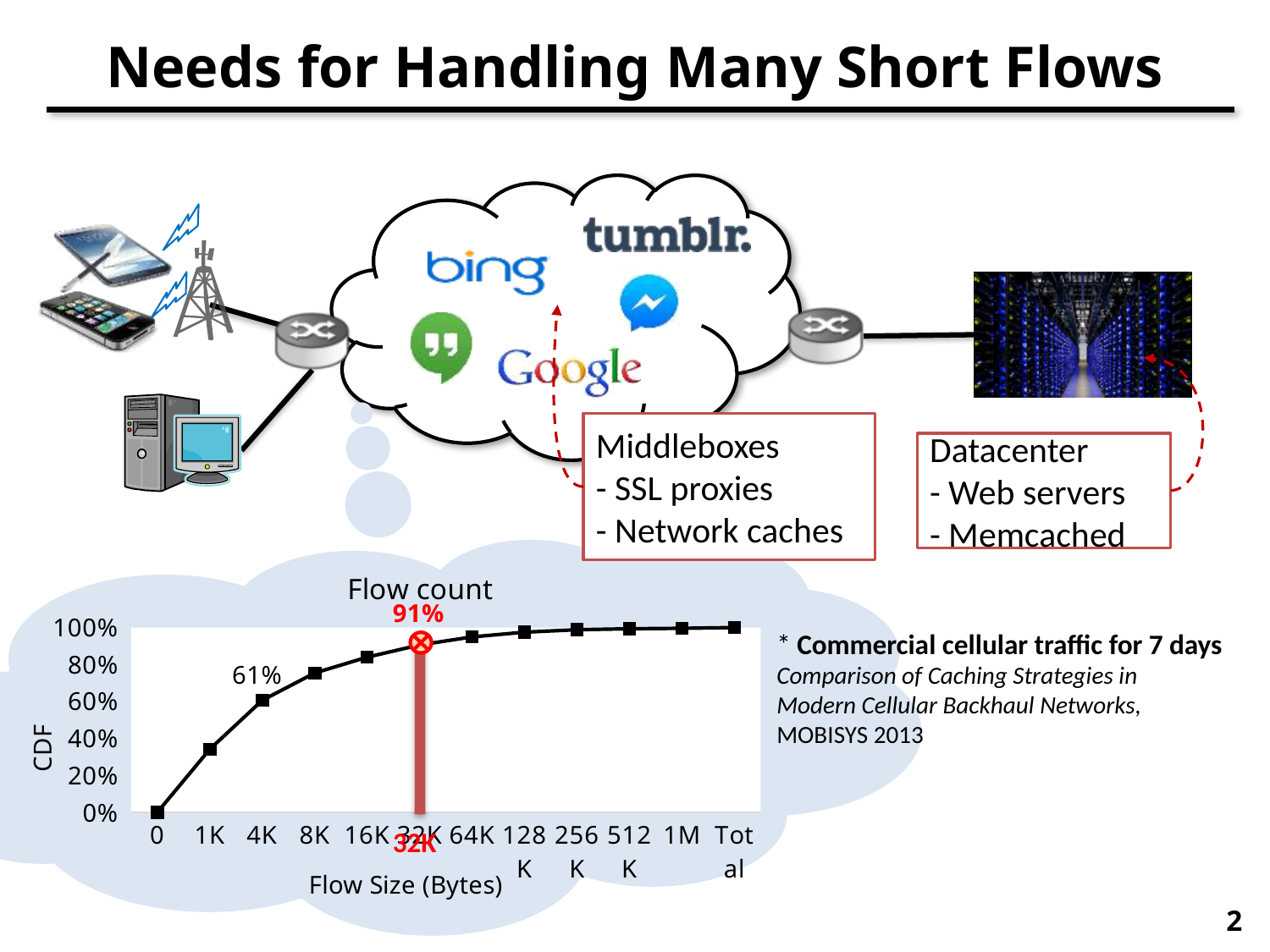
Is the CDF value at a flow size of 8K greater or less than 60%? greater What is the CDF value at a flow size of 32K bytes? 91% Is the CDF value at a flow size of 64K greater or less than 80%? greater Is the CDF value at a flow size of 1K greater or less than 60%? less How many flow size categories are shown on the x axis? 12 What kind of chart is shown on the slide? line chart What is the title of the chart? Flow count Which has the higher CDF value, flow size 4K or flow size 32K? 32K Does the CDF rise or fall as flow size increases along the x axis? rise What is the difference between the CDF values at 32K and 4K bytes? 30% What is the CDF value at a flow size of 0 bytes? 0% What is the CDF value at a flow size of 4K bytes? 61%